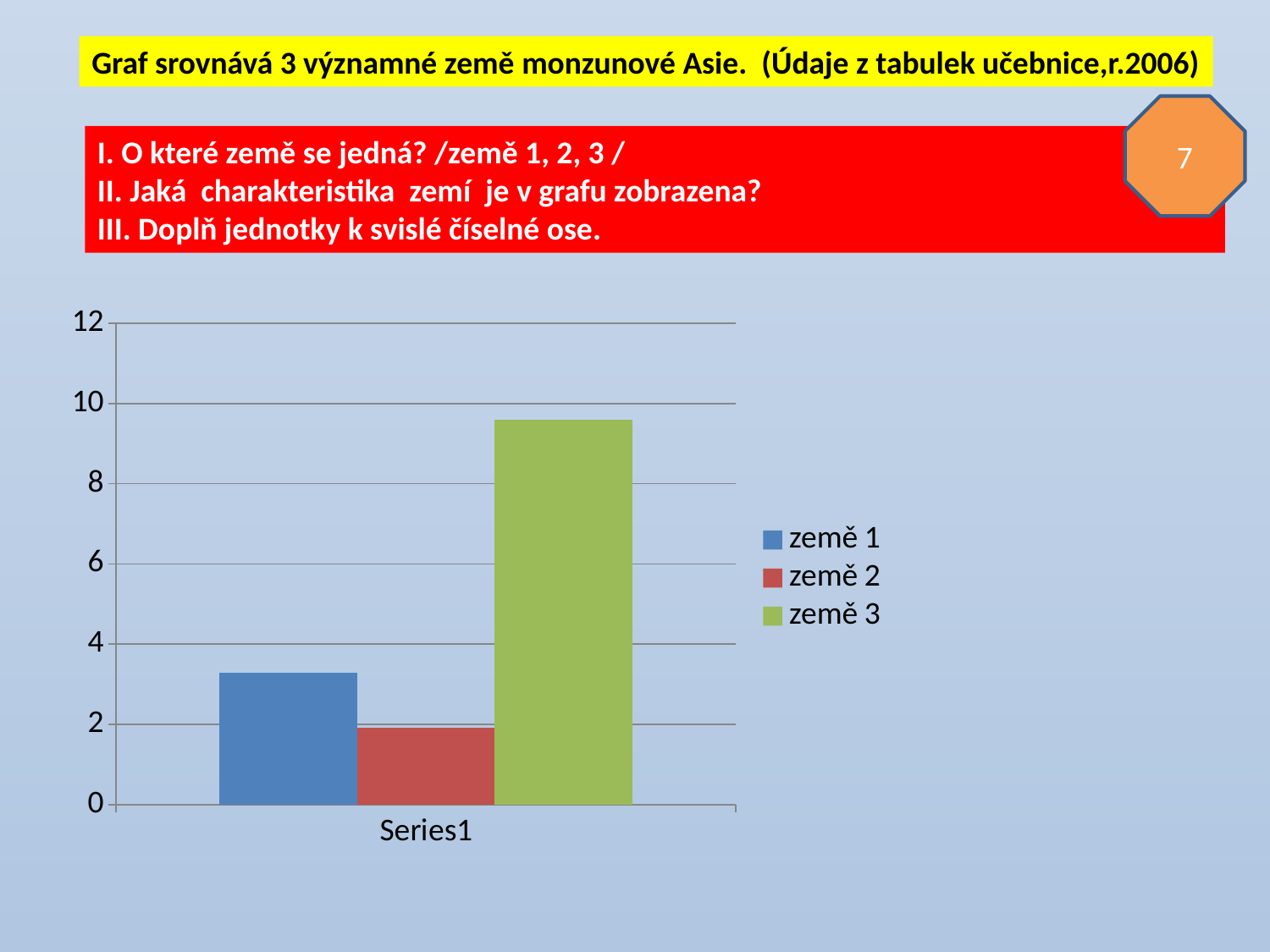
What kind of chart is shown on the slide? bar chart Is the value for země 3 greater or less than 8? greater Which series has the highest bar? země 3 Which is larger, the value for země 3 or the value for země 1? země 3 Is the value for země 3 greater or less than 10? less What colour is the bar for země 3? green Which is larger, the value for země 1 or the value for země 2? země 1 Which series has the lowest bar? země 2 How many series does the legend list? 3 What is the label shown on the horizontal axis of the chart? Series1 Is the value for země 1 greater or less than 4? less